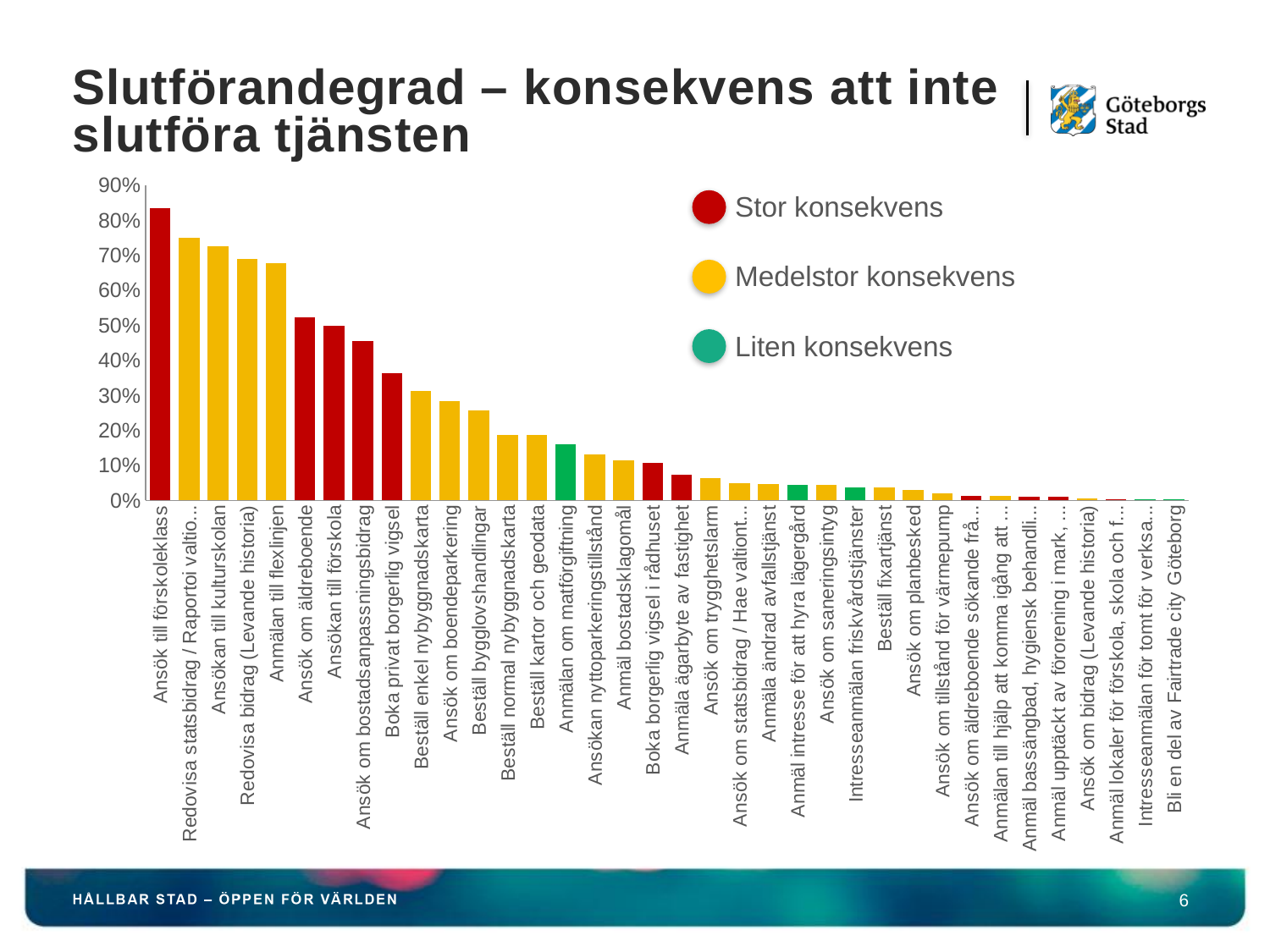
Do the bar values rise or fall from left to right along the x axis? fall Which is larger, the value for Ansök om boendeparkering or the value for Ansök om trygghetslarm? Ansök om boendeparkering Which is larger, the value for Anmälan till flexlinjen or the value for Ansökan till förskola? Anmälan till flexlinjen Is the value for Anmälan om matförgiftning greater or less than 20%? less What kind of chart is shown on the slide? bar chart Is the value for Ansök om äldreboende greater or less than 60%? less Is the value for Boka privat borgerlig vigsel greater or less than 30%? greater Which legend entry is shown in red? Stor konsekvens How many entries does the legend list? 3 Which category has the highest value in the chart? Ansök till förskoleklass